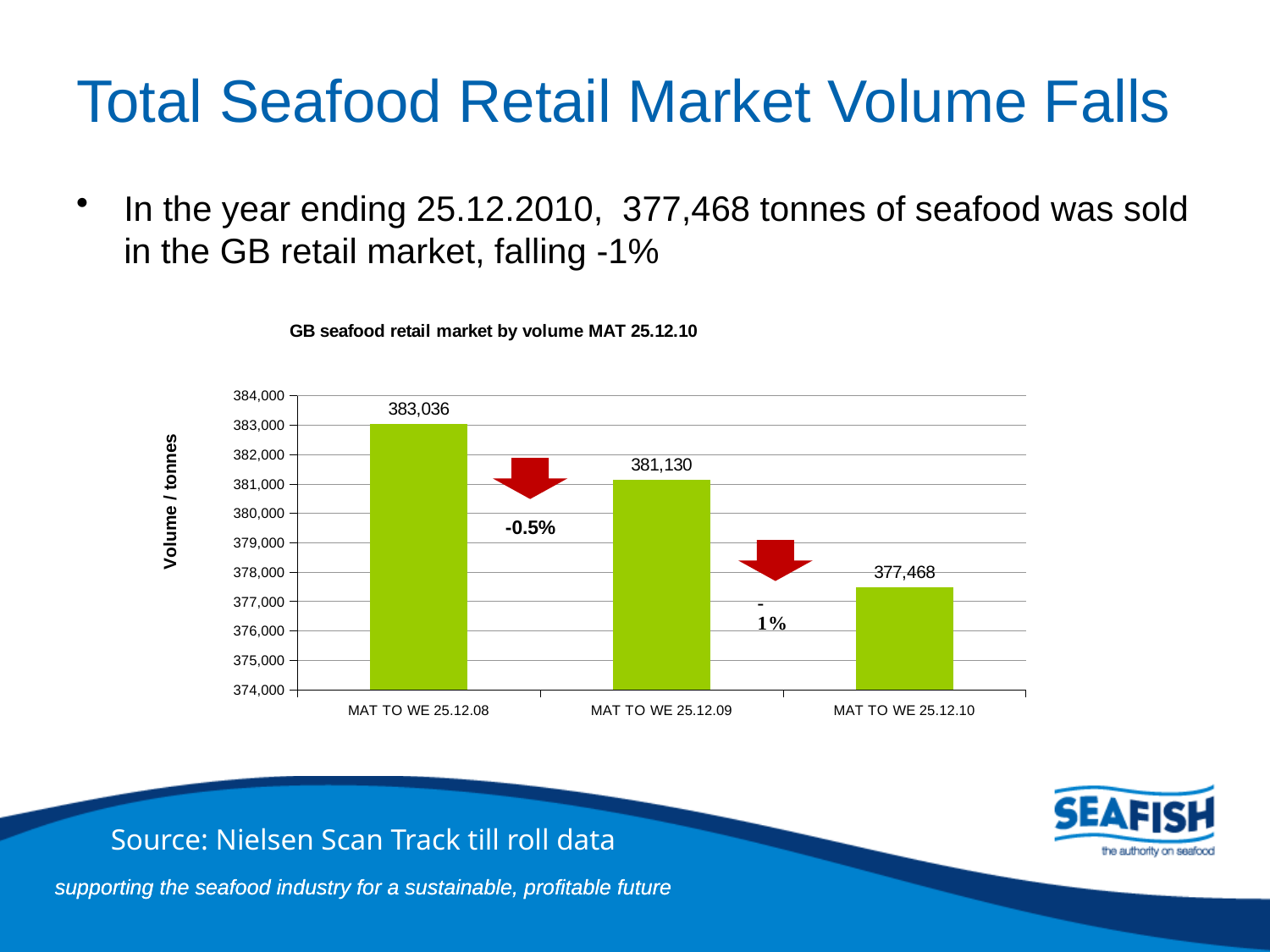
What is the volume for MAT TO WE 25.12.08? 383,036 Is the value for MAT TO WE 25.12.10 greater or less than 378,000? less Which period has the highest volume? MAT TO WE 25.12.08 What kind of chart is shown on the slide? bar chart What is the difference in volume between MAT TO WE 25.12.08 and MAT TO WE 25.12.09? 1,906 What is the volume for MAT TO WE 25.12.10? 377,468 What is the difference in volume between MAT TO WE 25.12.09 and MAT TO WE 25.12.10? 3,662 What is the volume for MAT TO WE 25.12.09? 381,130 Which is larger, the volume for MAT TO WE 25.12.09 or MAT TO WE 25.12.10? MAT TO WE 25.12.09 Do the volumes rise or fall across the periods from left to right? fall Which period has the lowest volume? MAT TO WE 25.12.10 How many periods are shown on the chart? 3